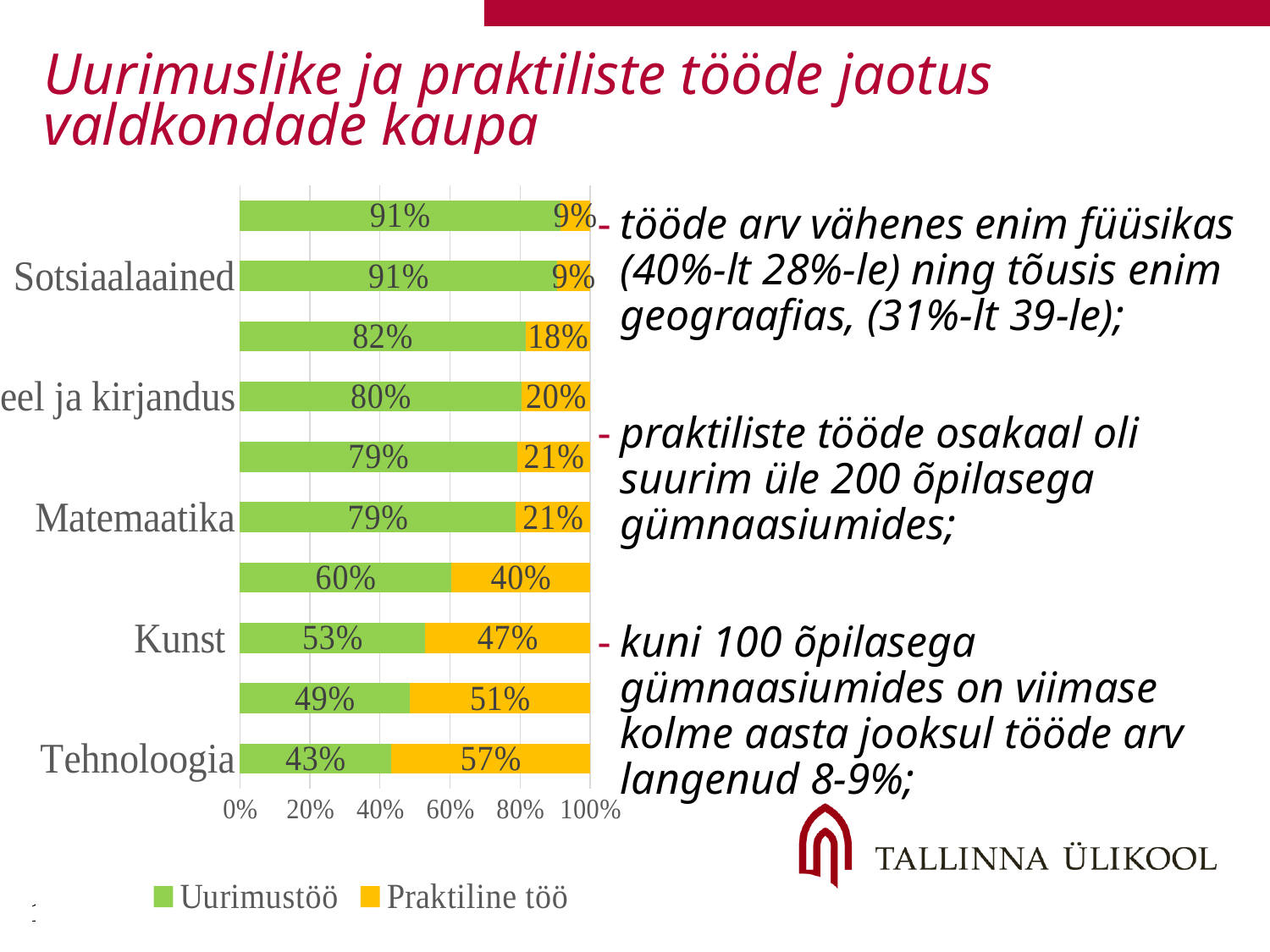
Which category has the highest Praktiline töö share? Tehnoloogia How many bars are plotted in the chart? 10 What is the Uurimustöö value for Matemaatika? 79% Which has a larger Praktiline töö share, Kunst or Matemaatika? Kunst What is the Praktiline töö value for Tehnoloogia? 57% What is the total of the stacked bar for Kunst? 100% What kind of chart is shown on the slide? Stacked horizontal bar chart What is the Uurimustöö value for Sotsiaalained? 91% How many series does the legend list? 2 What is the difference between the Uurimustöö values for Sotsiaalained and Tehnoloogia? 48 percentage points What is the Praktiline töö value for Kunst? 47% Which category has the lowest Uurimustöö share? Tehnoloogia